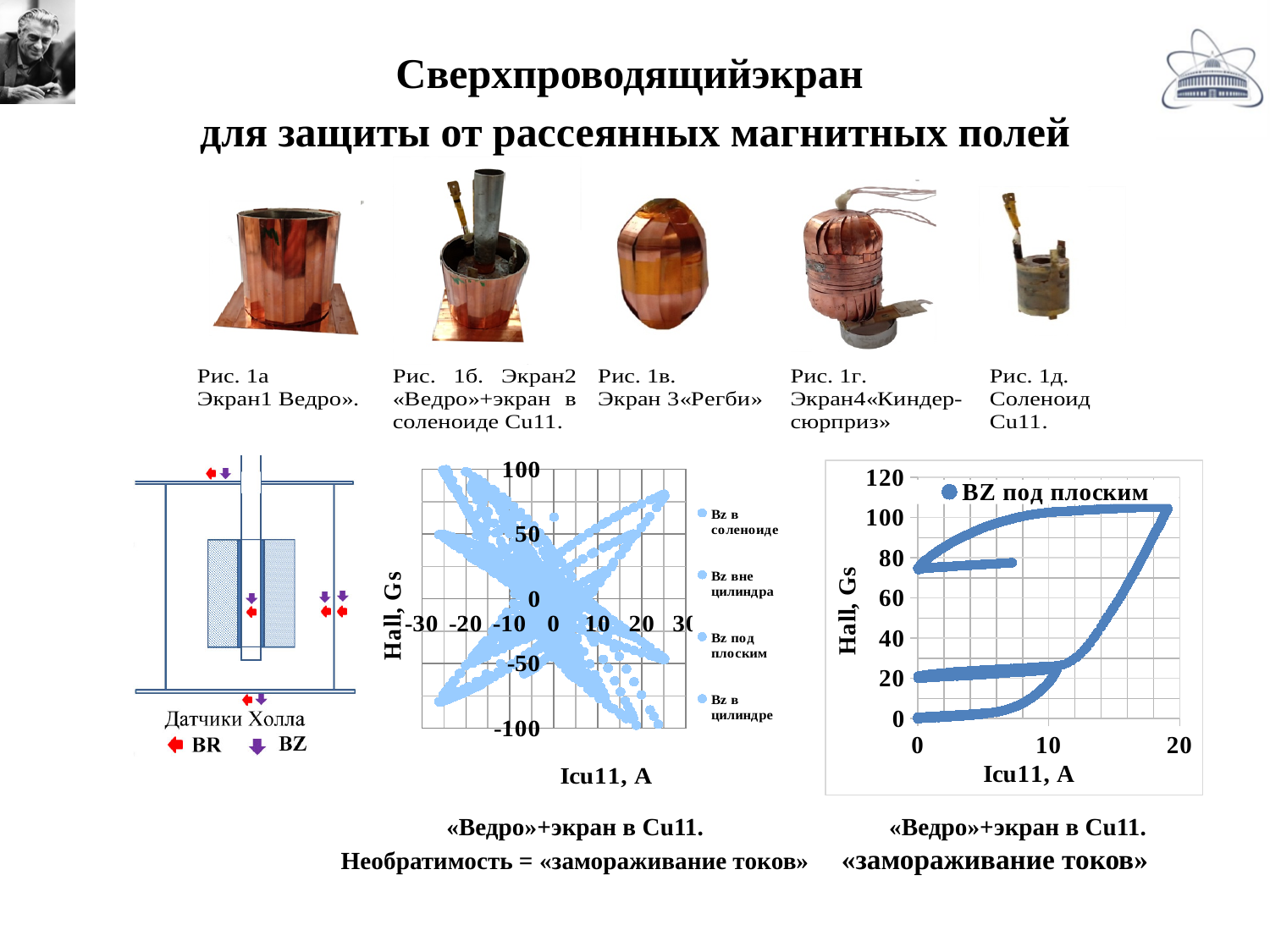
What kind of chart is the left chart with four legend entries? scatter chart What kind of chart is the right chart with the legend entry 'BZ под плоским'? scatter chart In the right chart, is the highest plotted Hall value greater or less than 120? less How many series does the legend of the left chart (with x axis Icu11, A from -30 to 30) list? 4 What is the y-axis label of the right chart? Hall, Gs What is the x-axis label of the left chart? Icu11, A How many series does the legend of the right chart list? 1 What is the maximum value shown on the x axis of the right chart? 20 In the right chart, is the highest plotted Hall value greater or less than 80? greater In the left chart, is the largest plotted Hall value greater or less than 50? greater